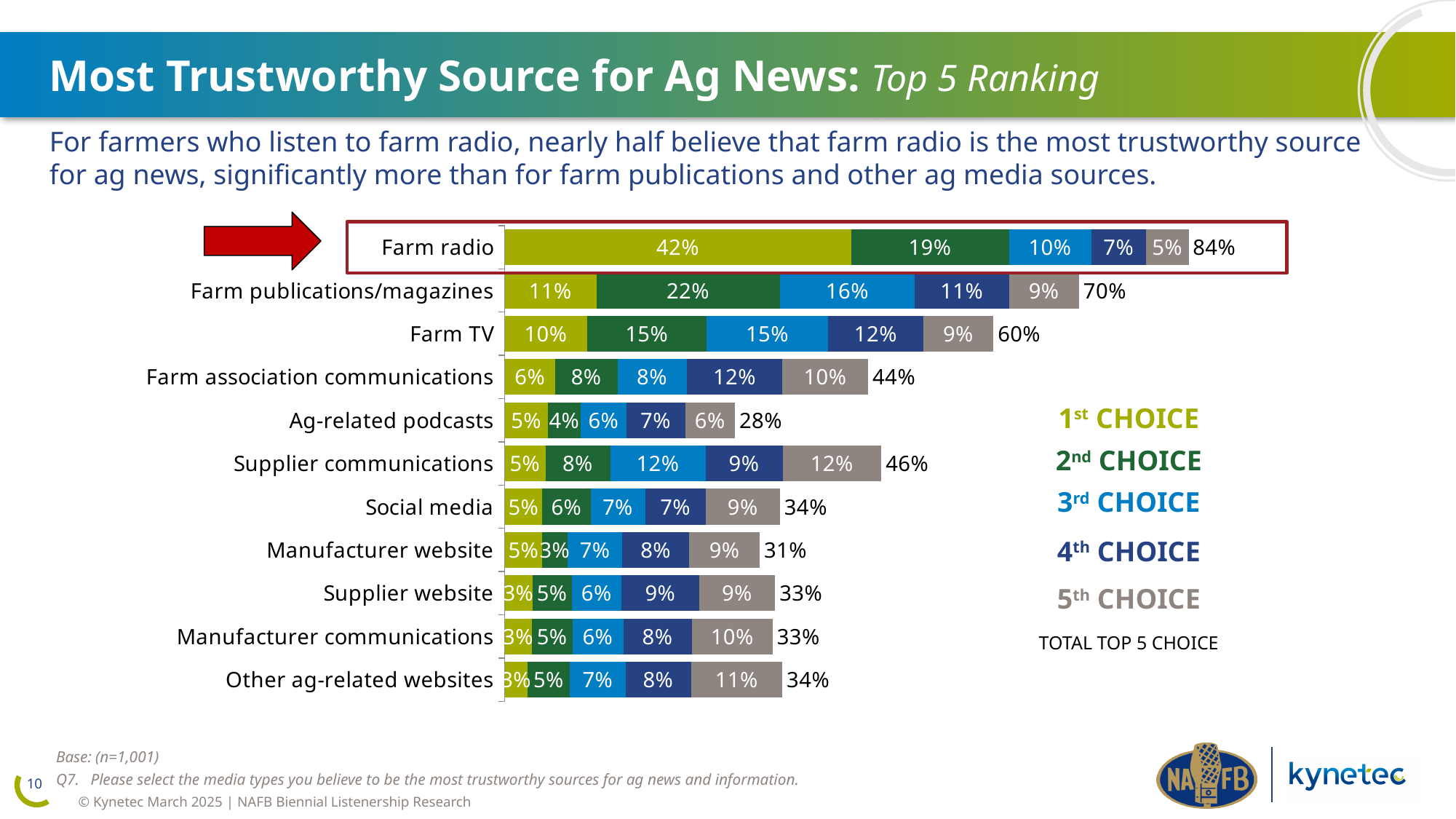
What kind of chart is shown on the slide? Stacked bar chart What is the 2nd choice value for Farm publications/magazines? 22% How many choice series does the legend list? 5 What is the total top 5 choice value for Farm TV? 60% What is the difference between the total top 5 choice values for Farm radio and Farm publications/magazines? 14% Which colour represents the 1st choice series in the chart? Yellow-green Which category has the highest total top 5 choice value? Farm radio What is the 1st choice value for Farm radio? 42% What is the 5th choice value for Other ag-related websites? 11% Which has a larger 3rd choice value, Supplier communications or Social media? Supplier communications How many categories are shown in the chart? 11 Which category has the lowest total top 5 choice value? Ag-related podcasts